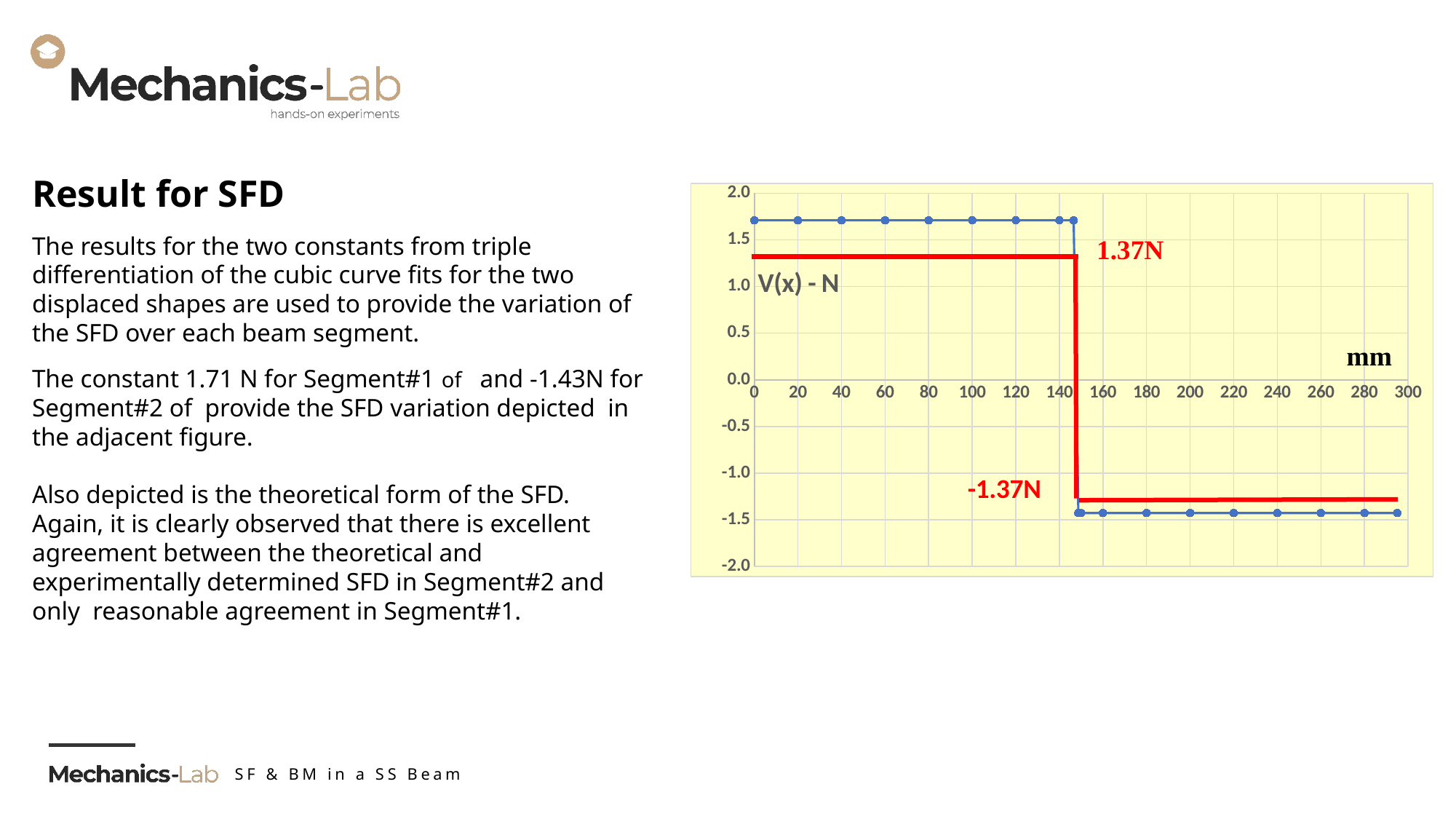
Do the plotted values rise or fall as x increases along the axis? fall Is the experimental (blue) value at 200 mm greater or less than -1.0? less What is the label shown on the vertical axis of the chart? V(x) - N What kind of chart is shown on the slide? line chart What value is labelled on the red theoretical line in the second segment of the chart? -1.37N Which is larger, the experimental value at 40 mm or at 200 mm? 40 mm What unit is shown for the horizontal axis of the chart? mm What is the highest tick value shown on the horizontal axis? 300 What value is labelled on the red theoretical line in the first segment of the chart? 1.37N Is the experimental (blue) value at 20 mm greater or less than 1.5? greater Is the experimental (blue) value at 100 mm greater or less than 2.0? less